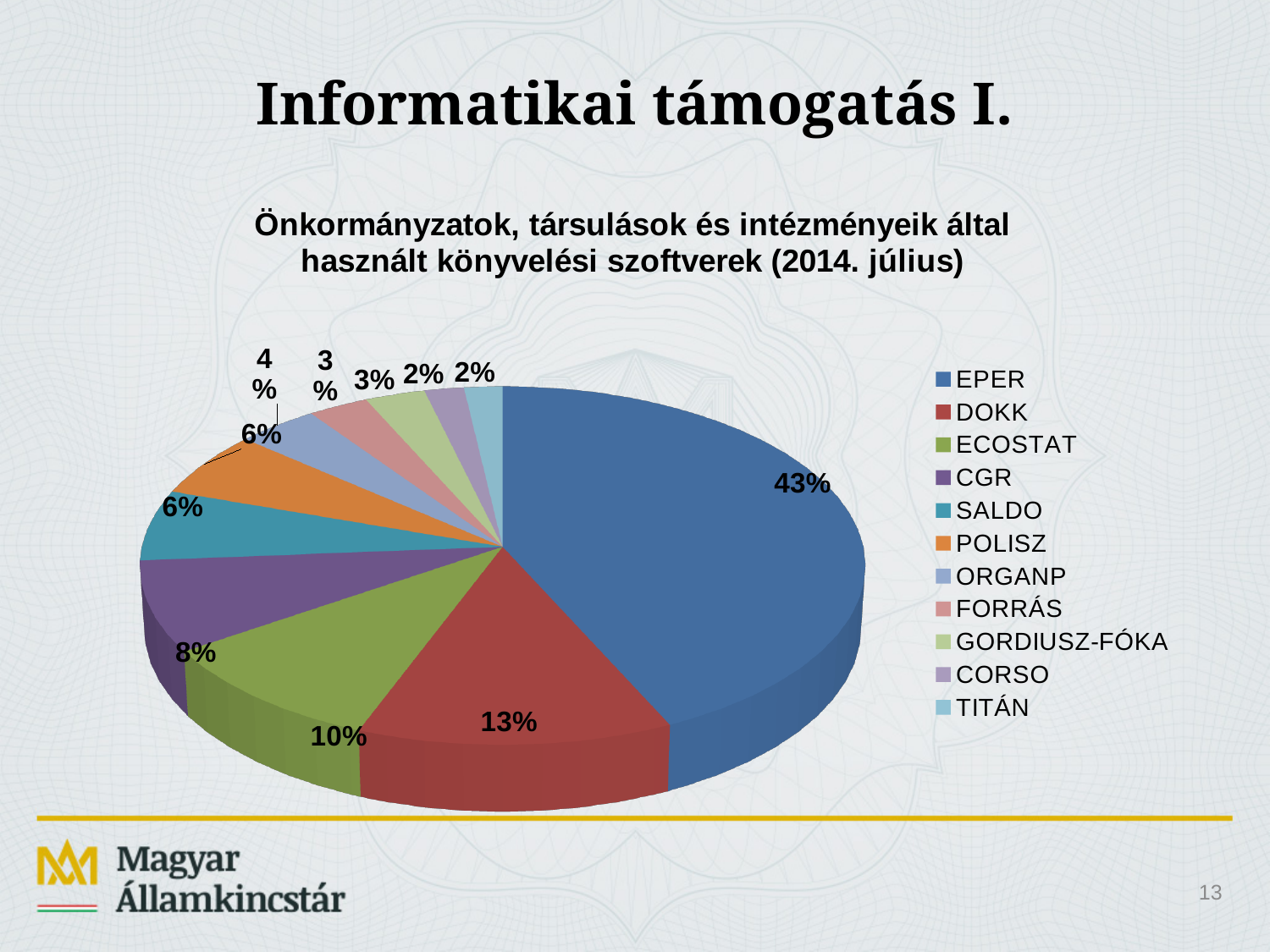
What percentage is shown for DOKK? 13% What percentage is shown for CGR? 8% Which has a larger share, DOKK or ECOSTAT? DOKK Which legend entry is listed last? TITÁN How many slices does the pie chart have? 11 What percentage is shown for ECOSTAT? 10% Which software has the largest share of the pie? EPER What share of the pie does EPER hold? 43% What is the difference in percentage points between EPER and DOKK? 30 percentage points What is the title of the chart? Önkormányzatok, társulások és intézményeik által használt könyvelési szoftverek (2014. július) What percentage is shown for SALDO? 6% What kind of chart is shown on the slide? Pie chart